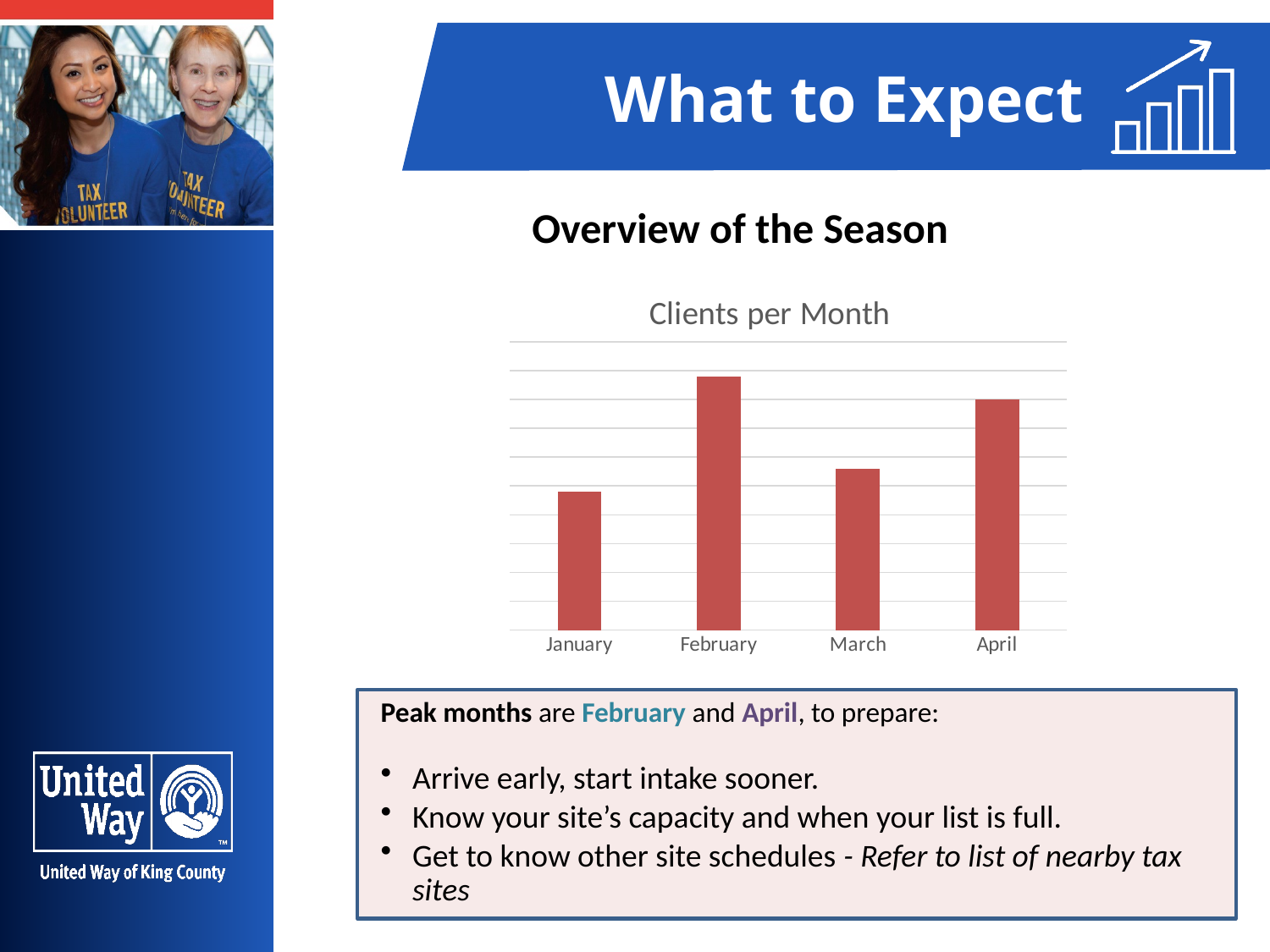
What type of chart is shown on the slide? bar chart Which month has the lowest number of clients? January What is the title of the chart? Clients per Month Do the values rise or fall from February to March? fall Which month has more clients, February or April? February Do the values rise or fall from January to February? rise Which month has more clients, April or March? April How many months are shown on the x axis of the chart? 4 Which month has more clients, March or January? March What colour are the bars in the chart? red Which month has the highest number of clients? February Which month has the second-highest number of clients? April